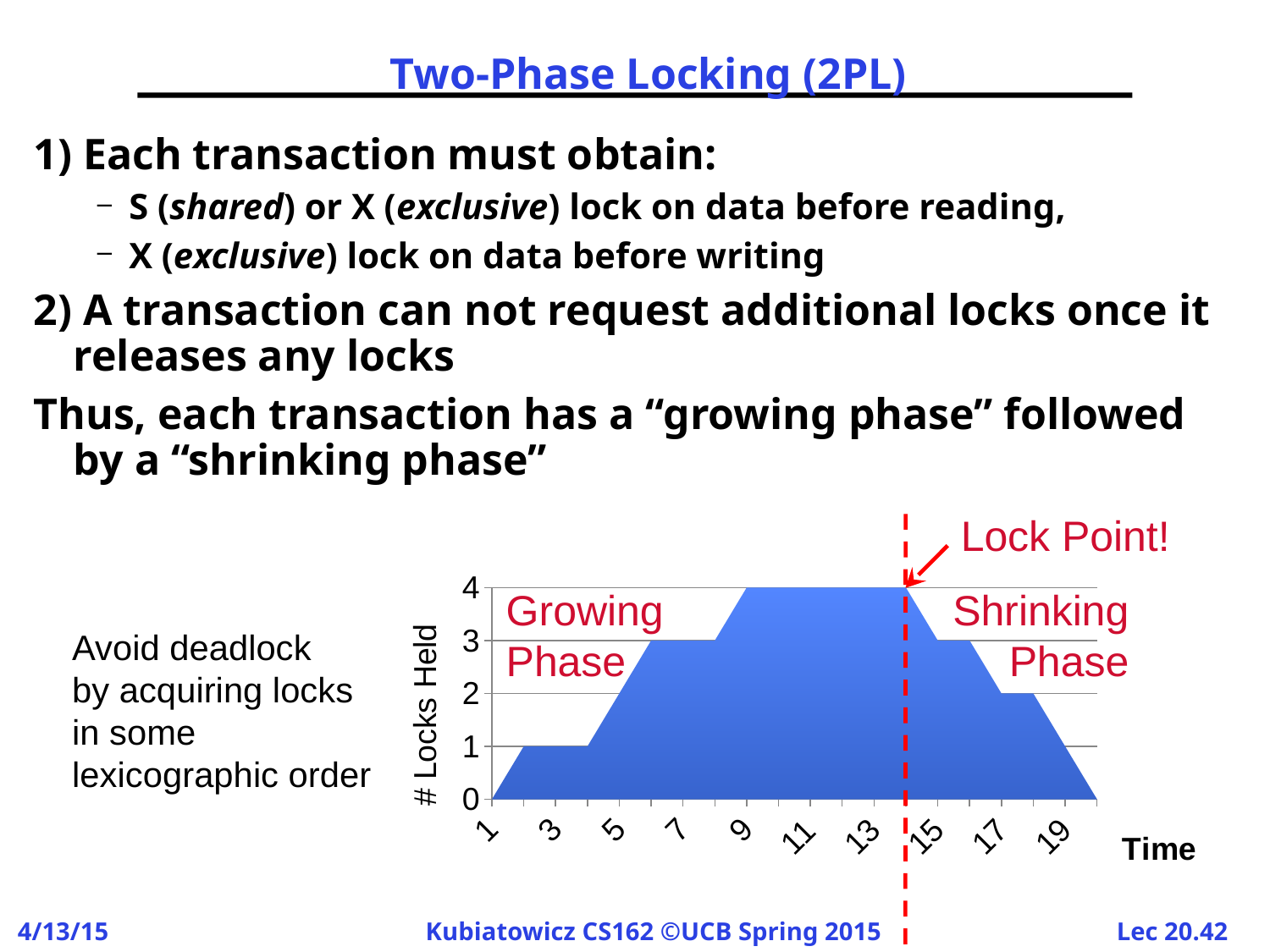
What is the label of the x-axis of the chart? Time What is the maximum number of locks held shown on the chart? 4 Is the number of locks held at time 3 greater or less than 2? less What is the label of the y-axis of the chart? # Locks Held Which is larger, the number of locks held at time 11 or at time 3? time 11 How many locks are held at time 11? 4 What type of chart is shown on the slide? area chart How many locks are held at time 1? 0 How many locks are held at time 3? 1 Is the number of locks held at time 11 greater or less than 2? greater How many locks are held at time 7? 3 How does the number of locks held change over time in the chart? rises, then falls